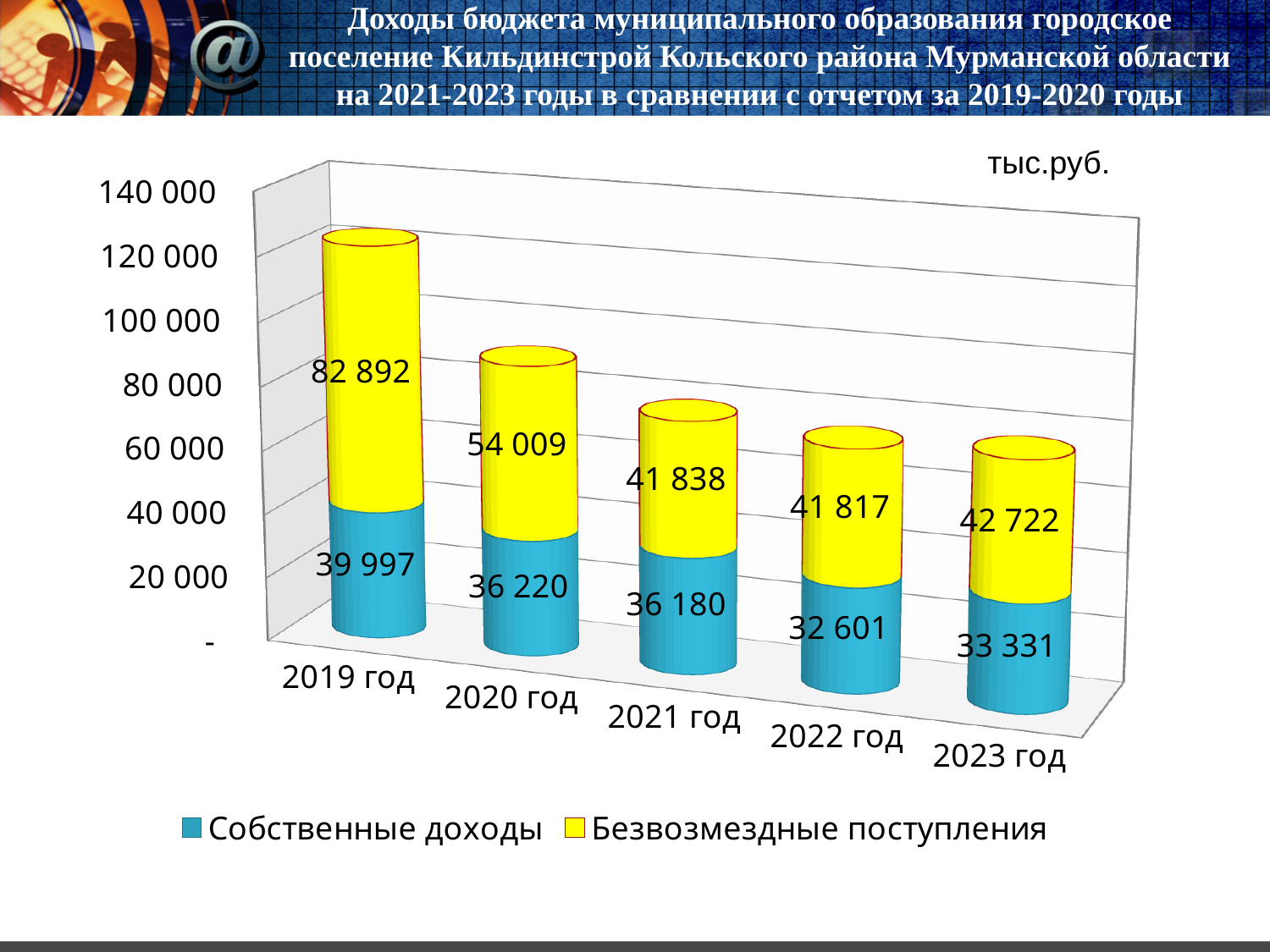
In which year is Собственные доходы the lowest? 2022 год What is the value of Безвозмездные поступления for 2023 год? 42 722 In which year is Безвозмездные поступления the highest? 2019 год Which is larger: Безвозмездные поступления in 2019 год or in 2020 год? 2019 год What is the total of the stacked bar for 2021 год? 78 018 How many years are shown on the x axis? 5 What type of chart is shown on the slide? stacked bar chart What is the difference between Безвозмездные поступления in 2019 год and 2020 год? 28 883 What is the value of Собственные доходы for 2019 год? 39 997 How many series does the legend list? 2 Is the total height of the 2019 год bar greater or less than 120 000? greater What is the value of Безвозмездные поступления for 2021 год? 41 838